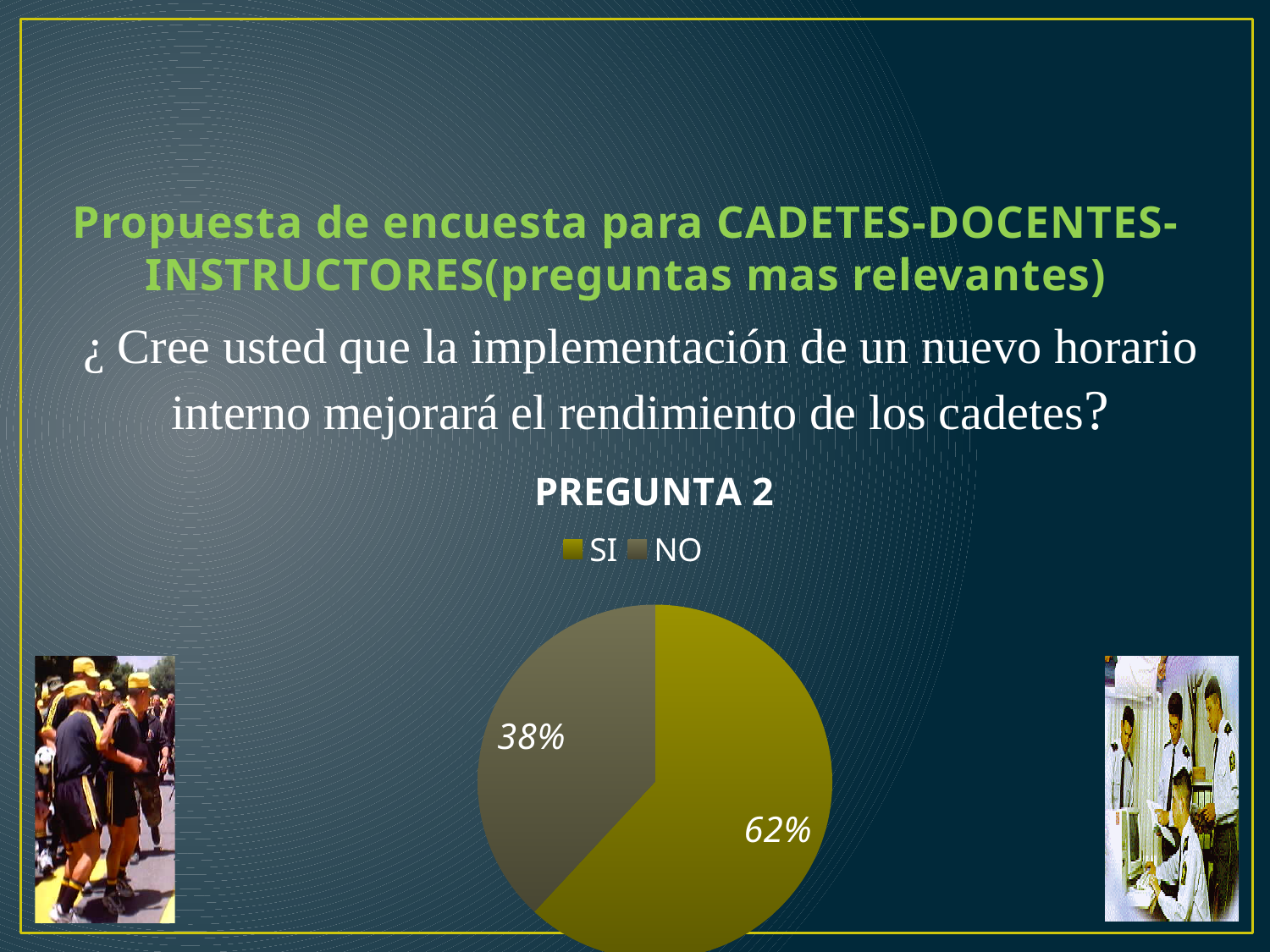
What type of chart is shown on the slide? pie chart Which slice of the pie is the largest? SI How many slices does the pie chart have? 2 How many entries does the legend list? 2 Which slice of the pie is the smallest? NO What percentage of the pie is labelled SI? 62% What is the title of the chart? PREGUNTA 2 What share of the pie does the NO slice represent? 38% Is the share for SI greater or less than 50%? greater Which is larger, the SI slice or the NO slice? SI What percentage of the pie is labelled NO? 38% What is the difference in percentage points between the SI and NO slices? 24